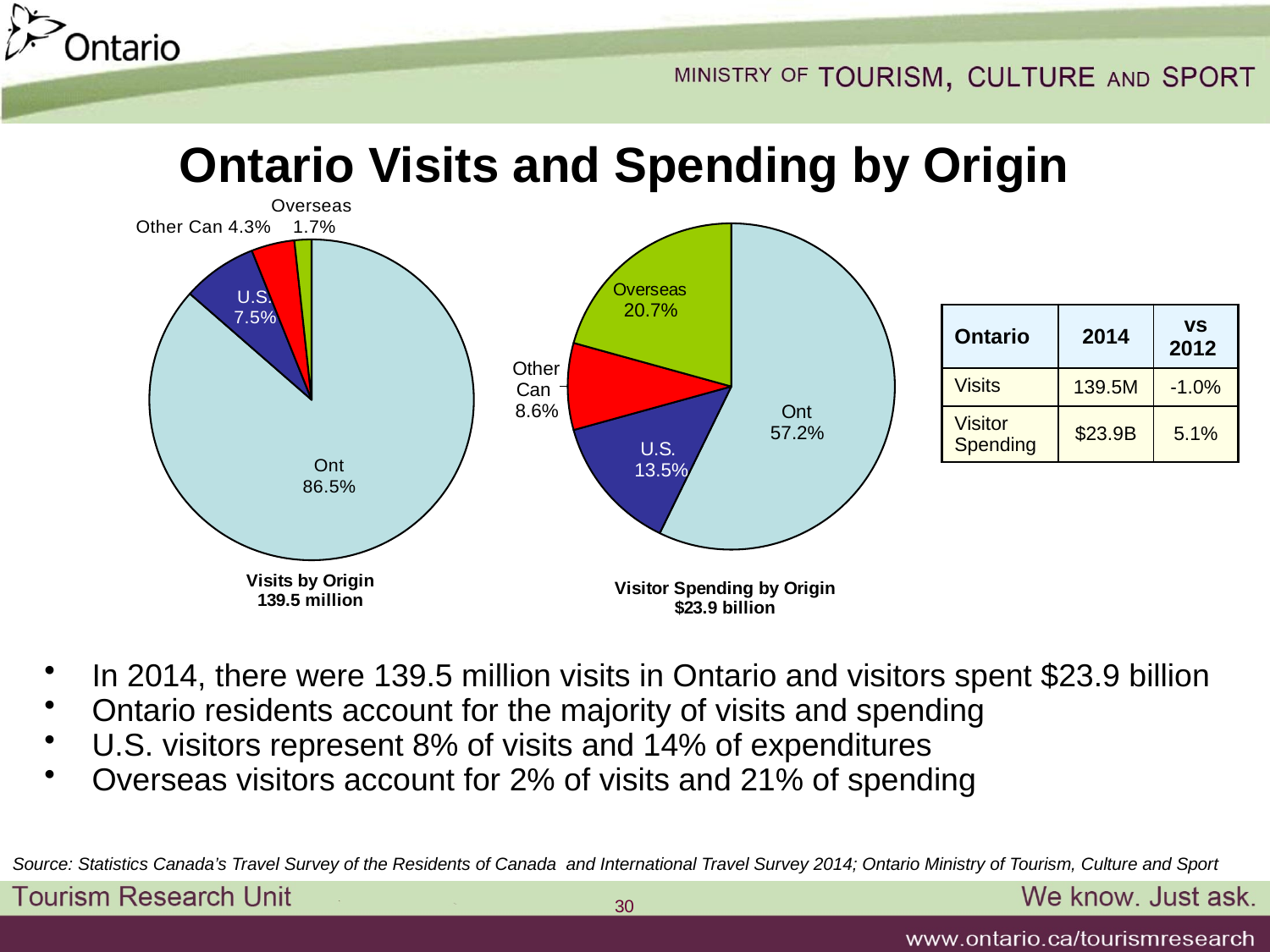
What type of chart is the Visitor Spending by Origin chart? Pie chart In the Visits by Origin pie chart, what share of visits comes from the U.S.? 7.5% In the Visitor Spending by Origin pie chart, what share of spending comes from Other Can? 8.6% In the Visitor Spending by Origin pie chart, which is larger: the U.S. slice or the Other Can slice? U.S. What is the difference between the Ontario share in the Visits by Origin chart and the Ontario share in the Visitor Spending by Origin chart? 29.3% In the Visitor Spending by Origin pie chart, which origin has the largest slice? Ont How many slices does the Visits by Origin pie chart have? 4 In the Visitor Spending by Origin pie chart, what share of spending comes from Overseas visitors? 20.7% What total value is shown beneath the Visitor Spending by Origin chart? $23.9 billion In the Visits by Origin pie chart, which origin has the smallest slice? Overseas